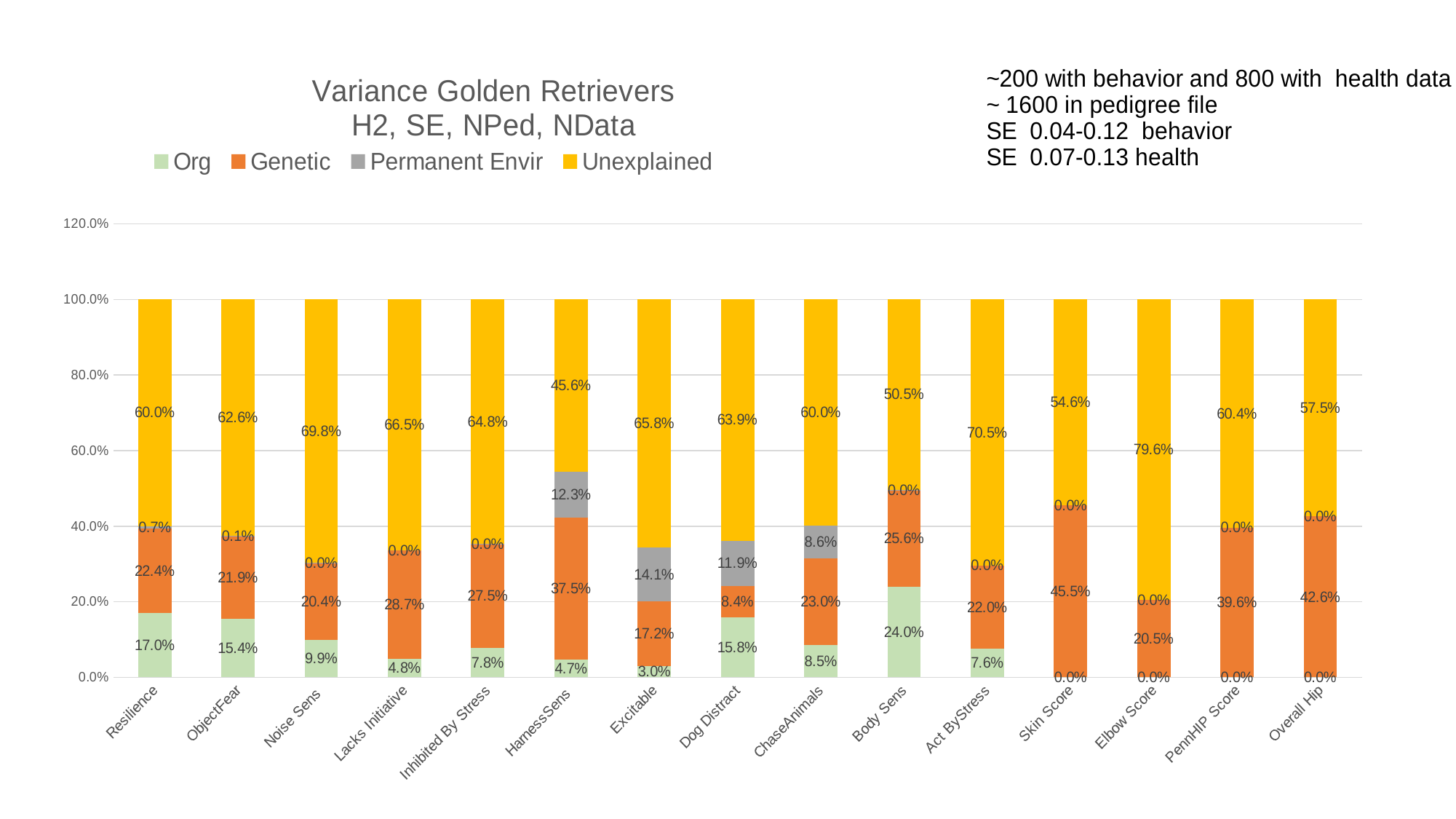
Which category has the highest Genetic value? Skin Score What is the Permanent Envir value for Excitable? 14.1% What is the Genetic value for HarnessSens? 37.5% How many series does the legend list? 4 What is the difference between the Genetic values for Skin Score and Elbow Score? 25.0% Which is larger, the Org value for Resilience or the Org value for ObjectFear? Resilience How many categories are shown on the x axis? 15 Which category has the highest Unexplained value? Elbow Score What kind of chart is shown on the slide? Stacked bar chart What is the Unexplained value for Elbow Score? 79.6% Which category has the lowest Unexplained value? HarnessSens What is the Org value for Body Sens? 24.0%